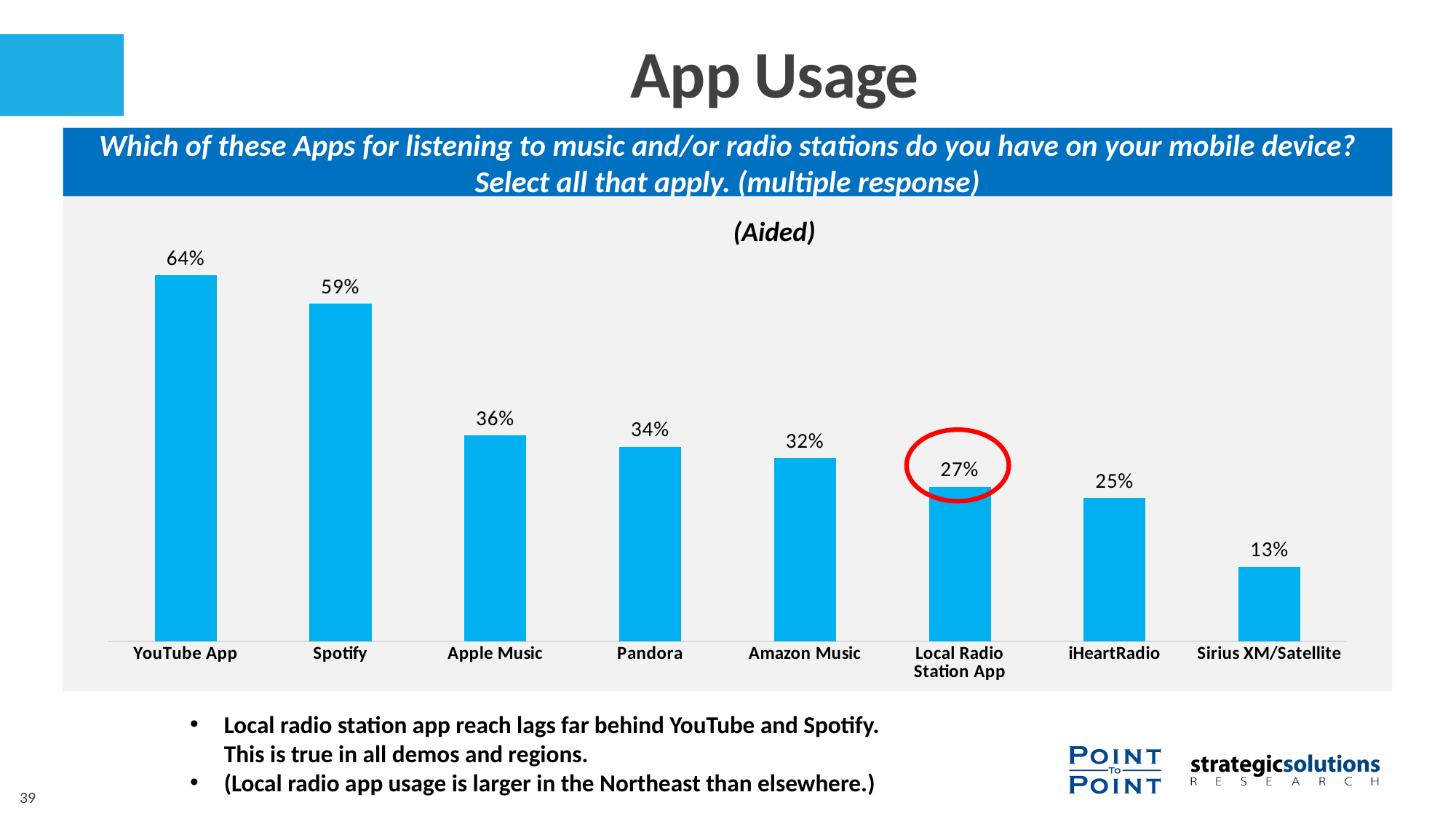
What is the value shown for Local Radio Station App? 27% How many apps are shown in the chart? 8 Do the values rise or fall from left to right across the chart? Fall What is the difference in percentage points between Spotify and Local Radio Station App? 32 What type of chart is shown on the slide? Bar chart What is the difference in percentage points between YouTube App and Spotify? 5 Which has a higher value, Pandora or iHeartRadio? Pandora What is the value shown for Amazon Music? 32% Which bar's data label is circled in red? Local Radio Station App Which app has the lowest percentage? Sirius XM/Satellite What percentage of respondents have the YouTube App on their mobile device? 64% Which app has the highest percentage? YouTube App